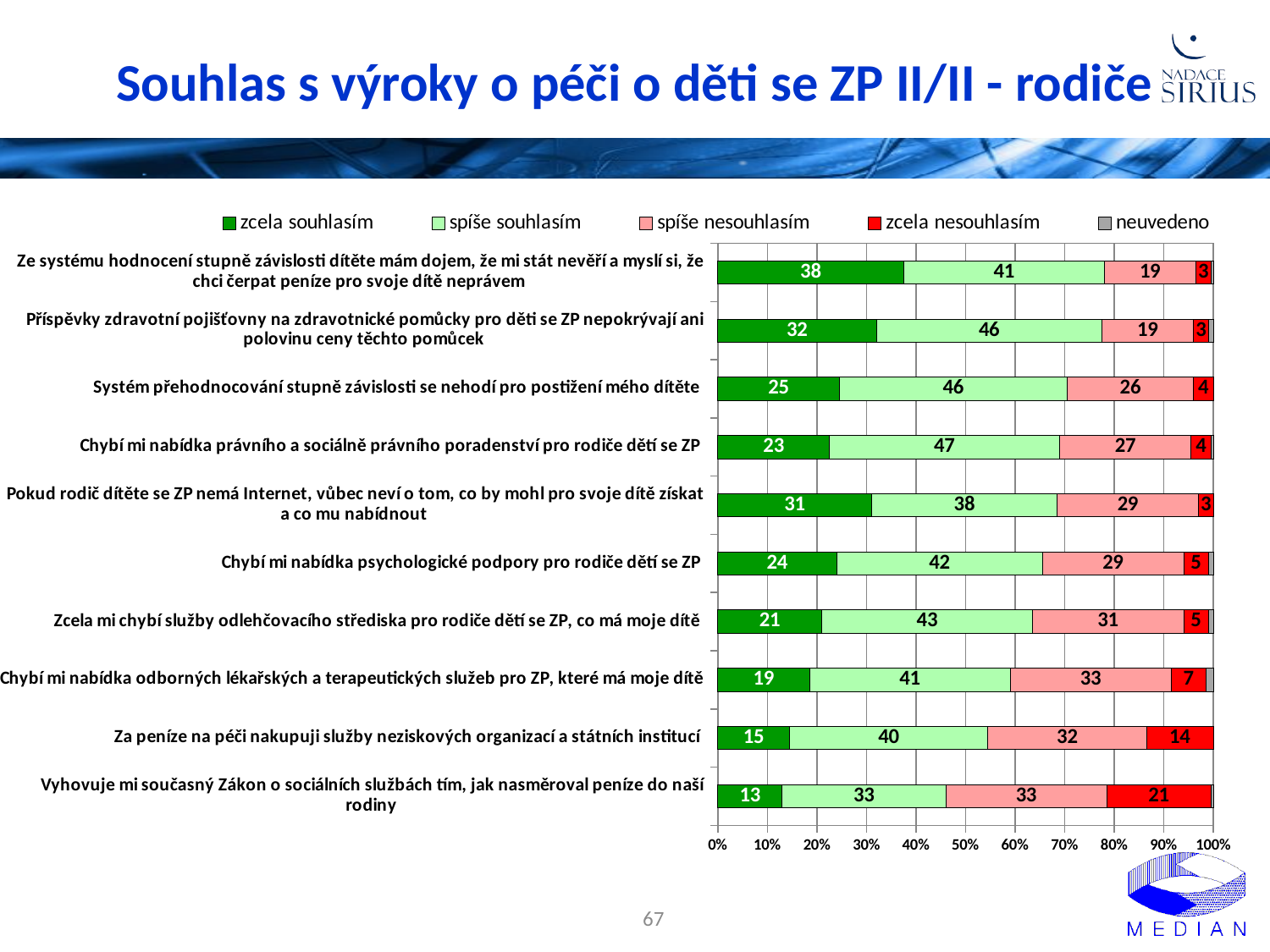
Which statement has the highest "zcela souhlasím" value? Ze systému hodnocení stupně závislosti dítěte mám dojem, že mi stát nevěří a myslí si, že chci čerpat peníze pro svoje dítě neprávem Which is larger: the "spíše souhlasím" value for "Příspěvky zdravotní pojišťovny na zdravotnické pomůcky pro děti se ZP nepokrývají ani polovinu ceny těchto pomůcek" or for "Pokud rodič dítěte se ZP nemá Internet, vůbec neví o tom, co by mohl pro svoje dítě získat a co mu nabídnout"? Příspěvky zdravotní pojišťovny na zdravotnické pomůcky pro děti se ZP nepokrývají ani polovinu ceny těchto pomůcek What type of chart is shown on the slide? Stacked bar chart How many statements (categories) are shown in the chart? 10 How many series does the legend list? 5 What is the difference between the "zcela souhlasím" values for "Za peníze na péči nakupuji služby neziskových organizací a státních institucí" and "Vyhovuje mi současný Zákon o sociálních službách tím, jak nasměroval peníze do naší rodiny"? 2 Which statement has the lowest "zcela souhlasím" value? Vyhovuje mi současný Zákon o sociálních službách tím, jak nasměroval peníze do naší rodiny Which legend entry is shown in red? zcela nesouhlasím What is the "spíše nesouhlasím" value for the statement "Chybí mi nabídka odborných lékařských a terapeutických služeb pro ZP, které má moje dítě"? 33 What percentage of parents answered "zcela souhlasím" to the statement "Systém přehodnocování stupně závislosti se nehodí pro postižení mého dítěte"? 25 What is the "spíše souhlasím" value for the statement "Chybí mi nabídka právního a sociálně právního poradenství pro rodiče dětí se ZP"? 47 What is the "zcela nesouhlasím" value for the statement "Vyhovuje mi současný Zákon o sociálních službách tím, jak nasměroval peníze do naší rodiny"? 21